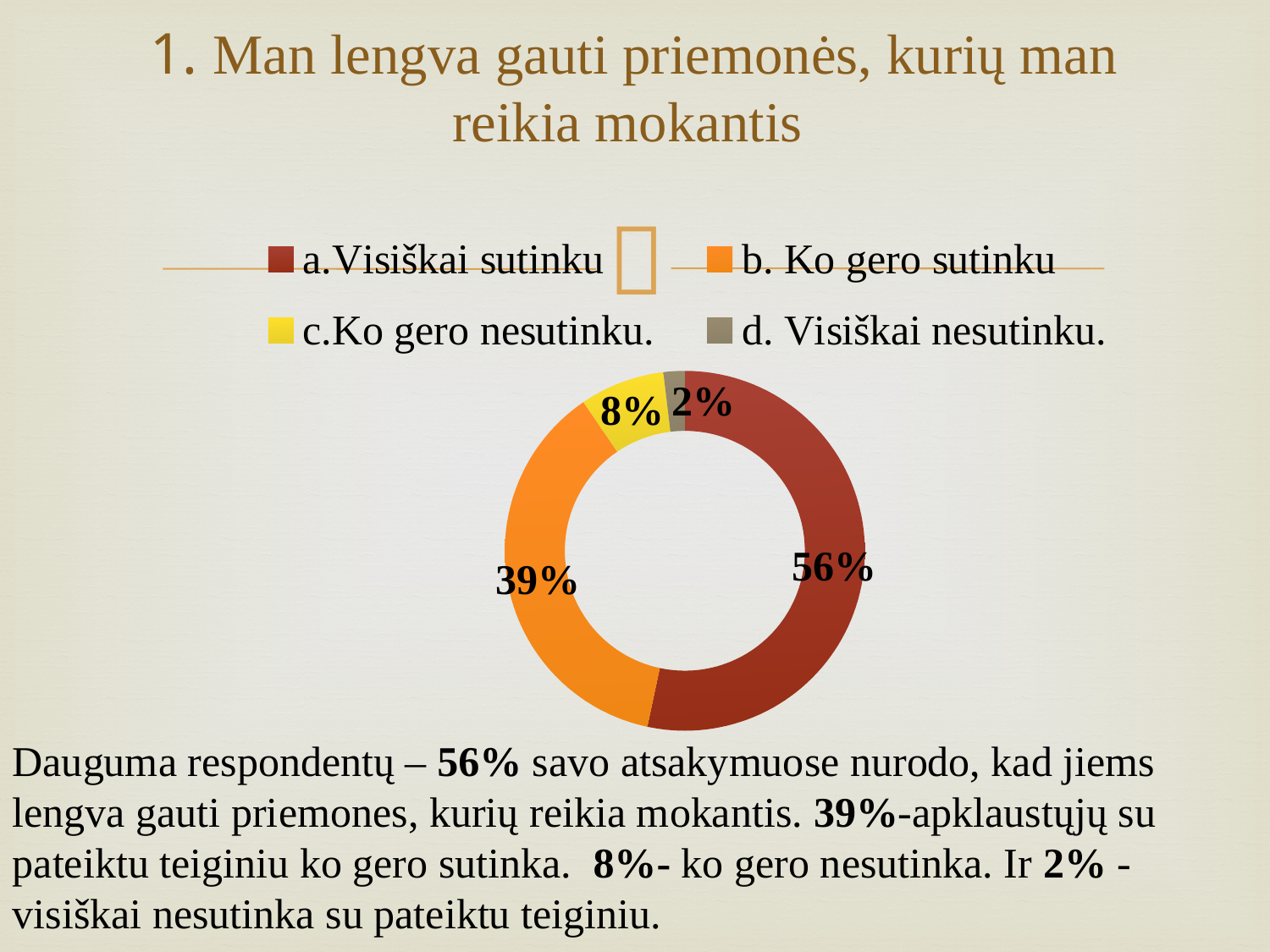
Which is larger: the share for "c.Ko gero nesutinku." or for "d. Visiškai nesutinku."? c.Ko gero nesutinku. What kind of chart is shown on the slide? Doughnut (pie) chart What percentage of respondents chose "b. Ko gero sutinku"? 39% Which answer option has the smallest share of the chart? d. Visiškai nesutinku. What colour represents "b. Ko gero sutinku" in the chart? Orange Which answer option has the largest share of the chart? a.Visiškai sutinku What percentage of respondents chose "d. Visiškai nesutinku."? 2% What percentage of respondents chose "a.Visiškai sutinku"? 56% What percentage of respondents chose "c.Ko gero nesutinku."? 8% What is the difference in percentage points between "a.Visiškai sutinku" and "b. Ko gero sutinku"? 17 How many answer options are shown in the chart? 4 How many entries does the legend list? 4